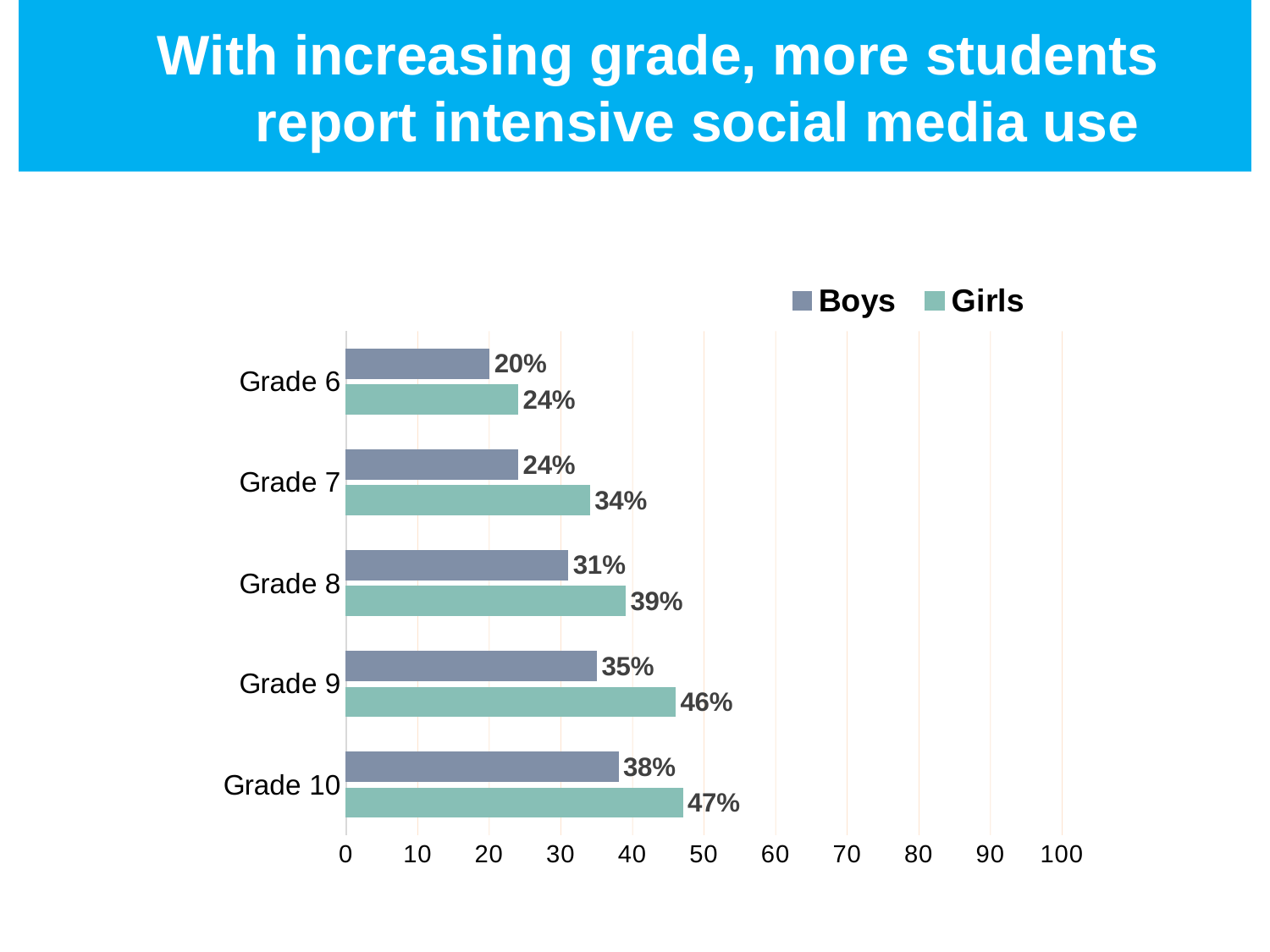
What percentage of Grade 6 boys report intensive social media use? 20% What is the difference between the Girls and Boys values in Grade 7? 10% How many series does the legend list? 2 How many grades are shown on the chart? 5 What is the value for Girls in Grade 9? 46% Which is larger in Grade 8: the value for Boys or for Girls? Girls What kind of chart is shown on the slide? Bar chart What is the difference between the Boys values for Grade 10 and Grade 6? 18% Which grade has the highest value for Girls? Grade 10 What is the value for Boys in Grade 8? 31% Which grade has the lowest value for Boys? Grade 6 Do the Girls values rise or fall from Grade 6 to Grade 10? Rise